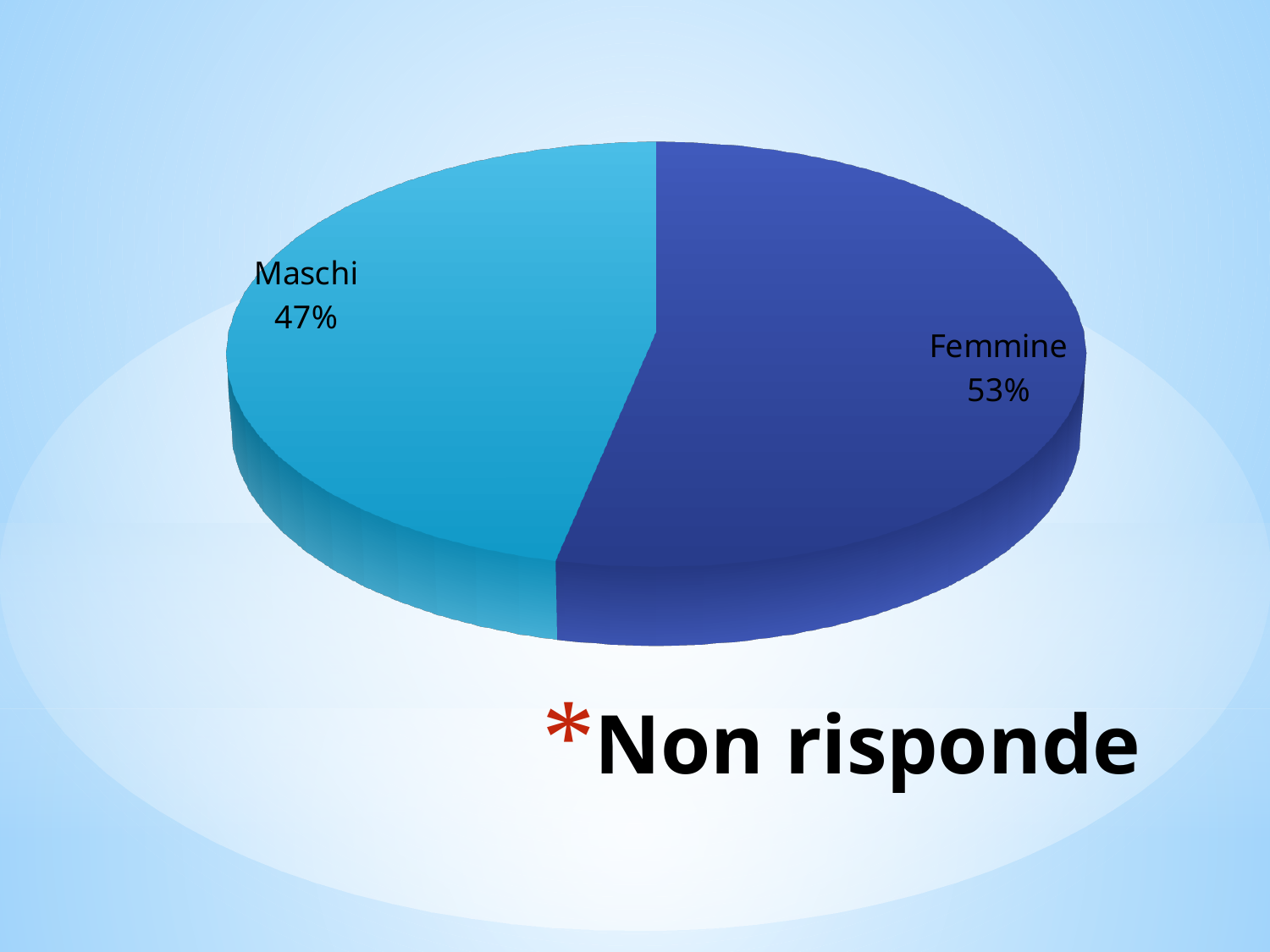
Which slice of the pie chart is the largest? Femmine What percentage of the pie chart is labelled Maschi? 47% Which slice of the pie chart is the smallest? Maschi What is the difference in percentage points between the Femmine and Maschi slices? 6 What kind of chart is shown on the slide? Pie chart Which slice is larger, Maschi or Femmine? Femmine What percentage of the pie chart is labelled Femmine? 53% How many slices does the pie chart have? 2 What text appears below the pie chart on the slide? Non risponde What colour is the Femmine slice of the pie chart? Dark blue What share of the pie does the Maschi slice represent? 47%